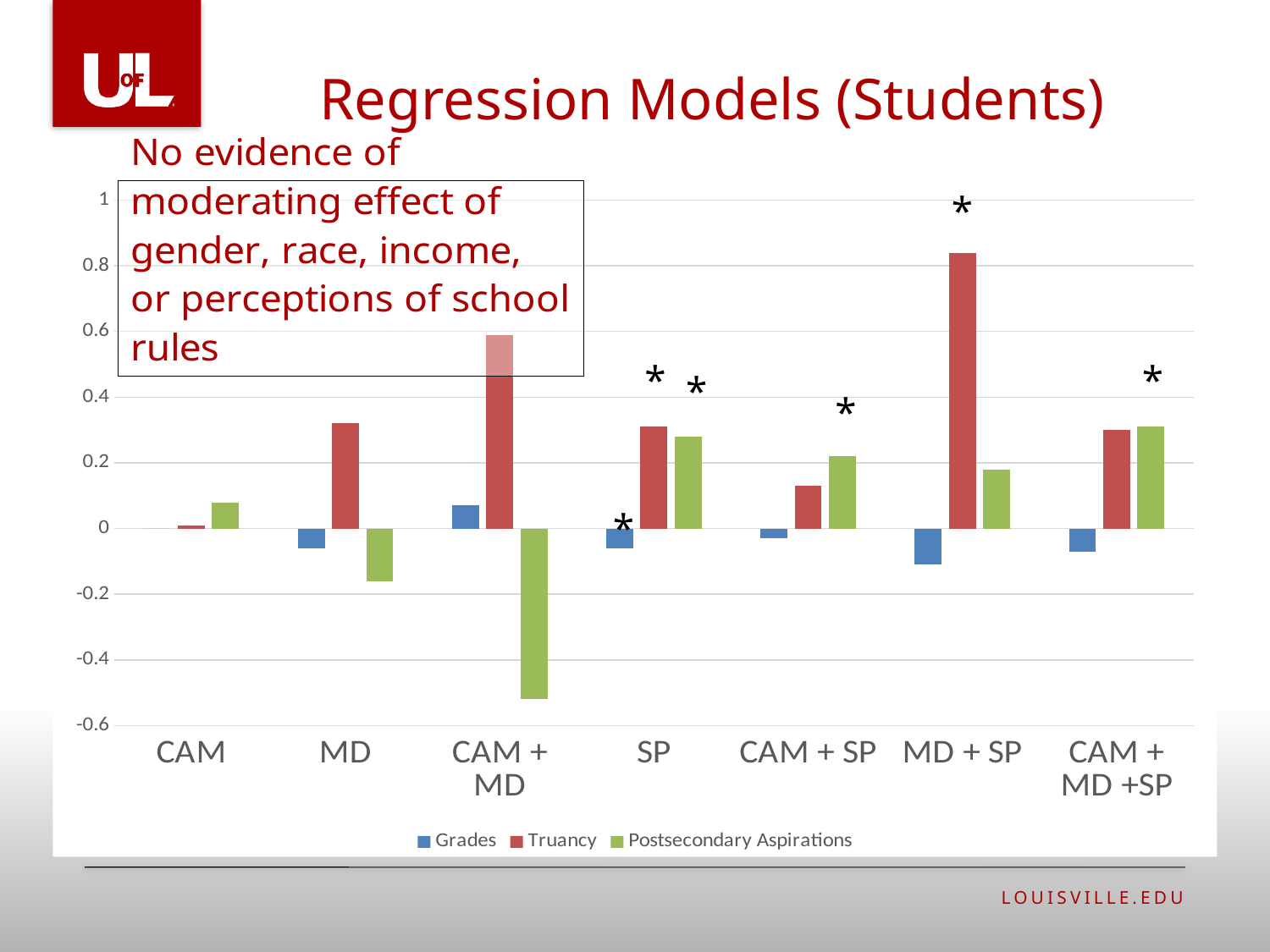
Which is larger, the Postsecondary Aspirations value for SP or the Postsecondary Aspirations value for MD? SP How many categories are shown along the x axis of the chart? 7 How many series does the chart's legend list? 3 Is the Truancy value for CAM + MD greater or less than 0.4? greater Is the Truancy value for MD + SP greater or less than 0.8? greater What colour represents the Truancy series in the chart? red Is the Postsecondary Aspirations value for CAM + MD greater or less than -0.4? less Which is larger, the Truancy value for MD + SP or the Truancy value for CAM + MD? MD + SP What kind of chart is shown on the slide? bar chart Which category has the highest Truancy value? MD + SP Which category has the lowest Postsecondary Aspirations value? CAM + MD What is the title of the chart on the slide? Regression Models (Students)